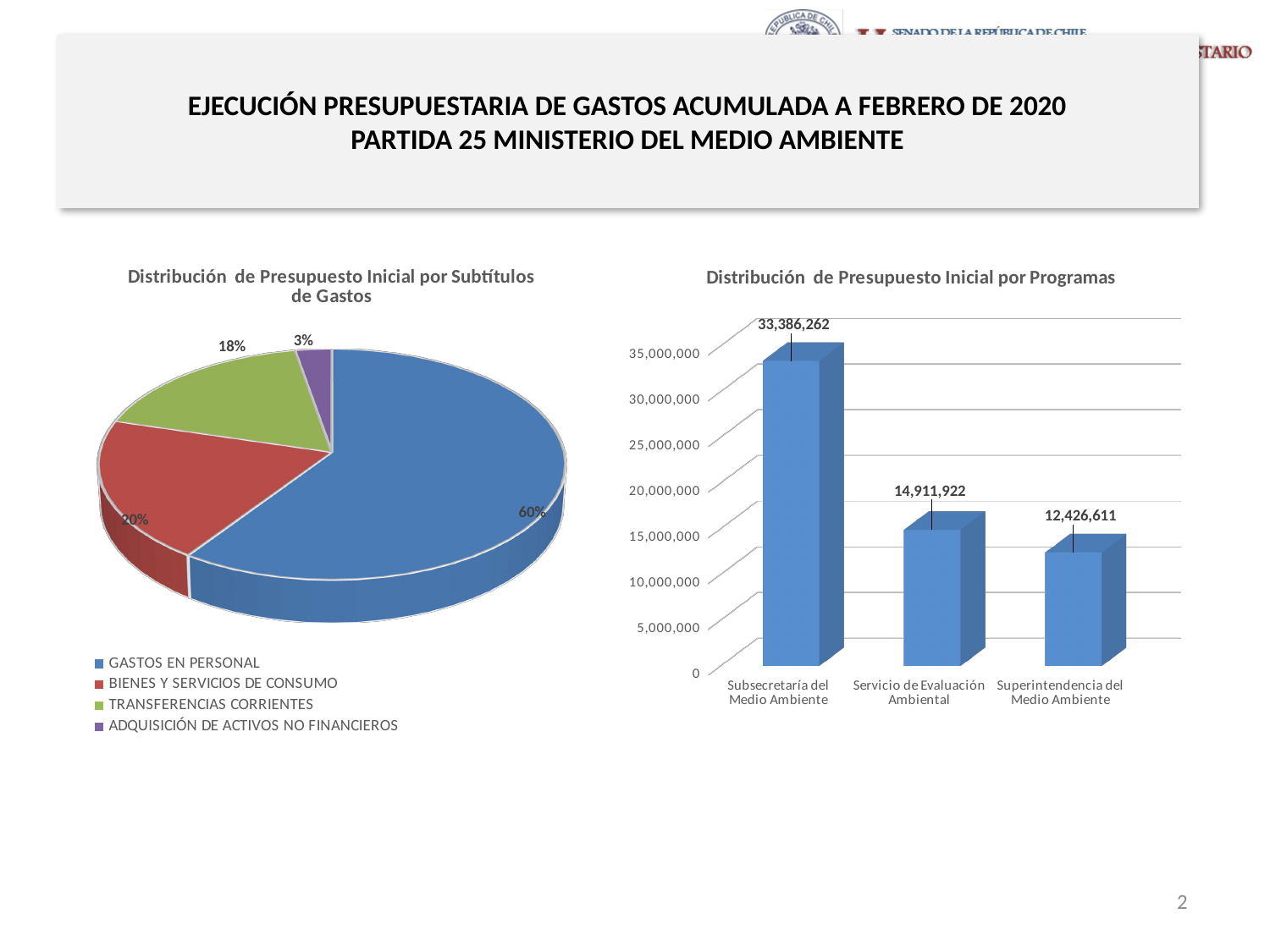
In the 'Distribución de Presupuesto Inicial por Subtítulos de Gastos' chart, what share does TRANSFERENCIAS CORRIENTES have? 18% In the 'Distribución de Presupuesto Inicial por Subtítulos de Gastos' chart, what share does GASTOS EN PERSONAL have? 60% In the 'Distribución de Presupuesto Inicial por Programas' chart, which program has the lowest value? Superintendencia del Medio Ambiente In the 'Distribución de Presupuesto Inicial por Programas' chart, what is the value for Subsecretaría del Medio Ambiente? 33,386,262 What kind of chart is 'Distribución de Presupuesto Inicial por Subtítulos de Gastos'? Pie chart In the 'Distribución de Presupuesto Inicial por Subtítulos de Gastos' chart, which category has the smallest slice? ADQUISICIÓN DE ACTIVOS NO FINANCIEROS How many categories does the legend of the 'Distribución de Presupuesto Inicial por Subtítulos de Gastos' chart list? 4 In the 'Distribución de Presupuesto Inicial por Programas' chart, what is the value for Superintendencia del Medio Ambiente? 12,426,611 In the 'Distribución de Presupuesto Inicial por Subtítulos de Gastos' chart, which category has the largest slice? GASTOS EN PERSONAL In the 'Distribución de Presupuesto Inicial por Programas' chart, what is the difference between Servicio de Evaluación Ambiental and Superintendencia del Medio Ambiente? 2,485,311 What kind of chart is 'Distribución de Presupuesto Inicial por Programas'? Bar chart In the 'Distribución de Presupuesto Inicial por Programas' chart, do the values rise or fall from left to right? Fall